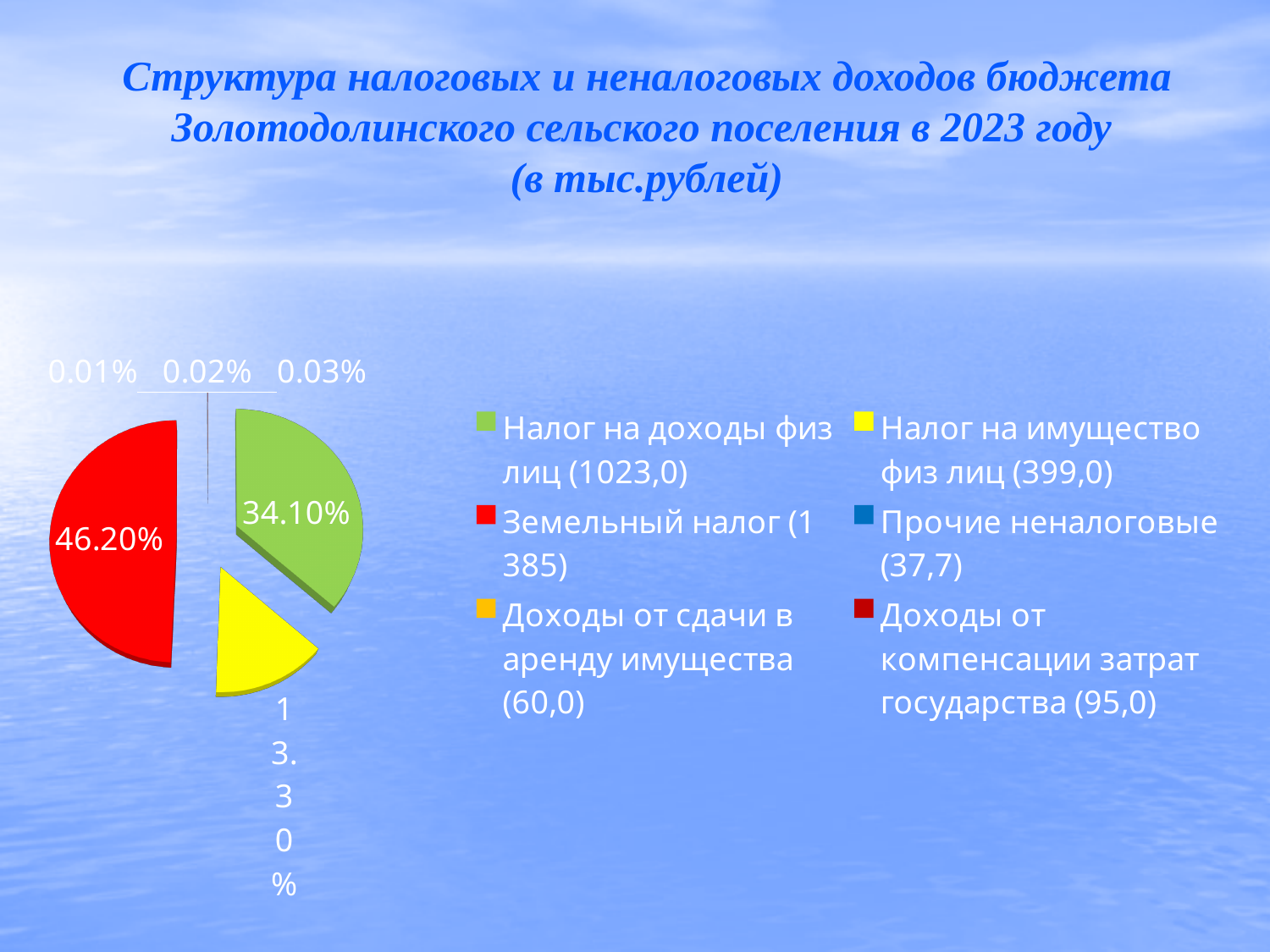
What share of the pie does the slice for Налог на доходы физ лиц (1023,0) have? 34.10% Which is larger: the slice for Налог на доходы физ лиц or the slice for Налог на имущество физ лиц? Налог на доходы физ лиц What colour is the slice representing Налог на имущество физ лиц? yellow What is the difference in percentage points between the Налог на доходы физ лиц slice and the Налог на имущество физ лиц slice? 20.80% How many entries does the chart legend list? 6 What share of the pie does the slice for Земельный налог (1 385) have? 46.20% What kind of chart is shown on the slide? pie chart Which category has the largest slice of the pie? Земельный налог (1 385) What share of the pie does the slice for Налог на имущество физ лиц (399,0) have? 13.30% What is the difference in percentage points between the Земельный налог slice and the Налог на доходы физ лиц slice? 12.10% What colour is the slice representing Земельный налог? red Is the share for Земельный налог greater or less than 40%? greater